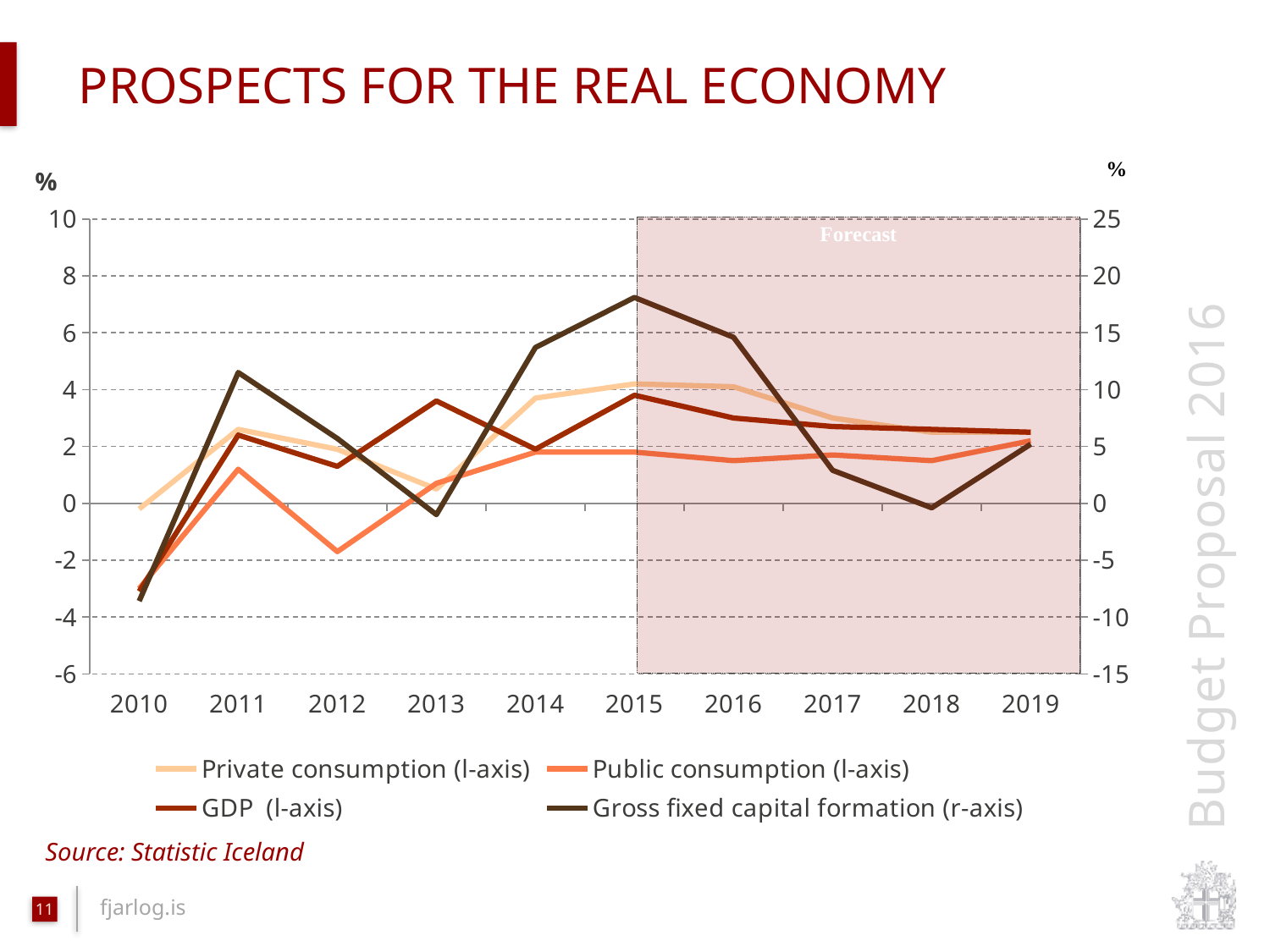
How many years are shown on the x axis? 10 In which year does Gross fixed capital formation reach its highest value? 2015 Is the value for Public consumption in 2012 greater or less than 0? less Which series is plotted on the right axis? Gross fixed capital formation Is the value for Private consumption in 2014 greater or less than 2? greater Is the value for GDP in 2010 greater or less than -2? less Does Gross fixed capital formation rise or fall from 2015 to 2018? Fall What kind of chart is shown on the slide? Line chart How many series does the legend list? 4 In 2013, which is larger: GDP or Private consumption? GDP In which year is Public consumption at its lowest? 2010